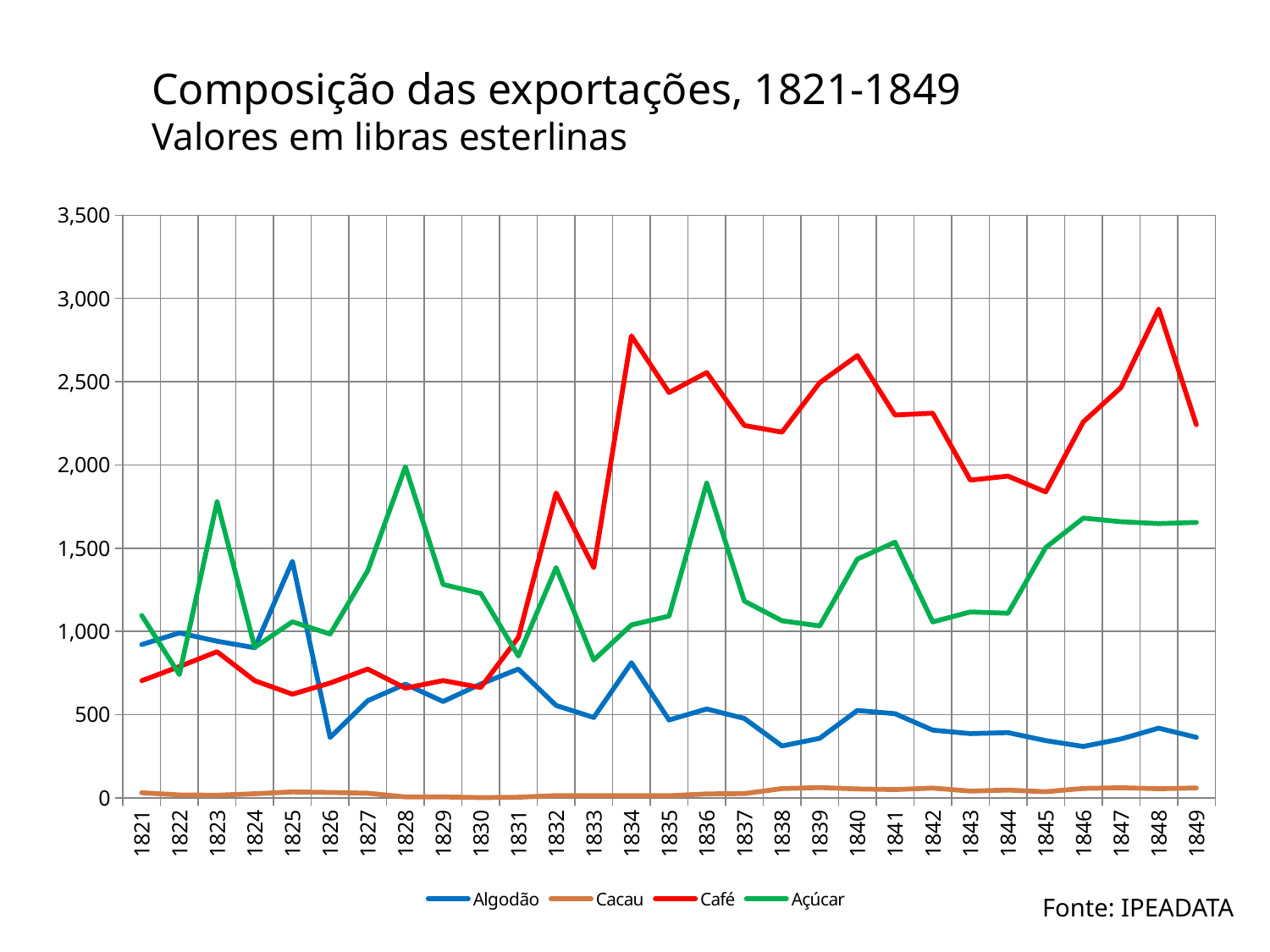
Is the value for Algodão in 1826 greater or less than 500? less Is the value for Café in 1848 greater or less than 2,500? greater What kind of chart is shown on the slide? line chart What is the source cited for the chart? IPEADATA In which year does Café reach its highest value? 1848 How many years are plotted along the x axis? 29 In 1825, which is larger: Algodão or Café? Algodão How many series does the legend list? 4 In 1849, which is larger: Café or Açúcar? Café Which series has the lowest value in 1840? Cacau Is the value for Açúcar in 1828 greater or less than 1,500? greater Which series has the highest value in 1848? Café